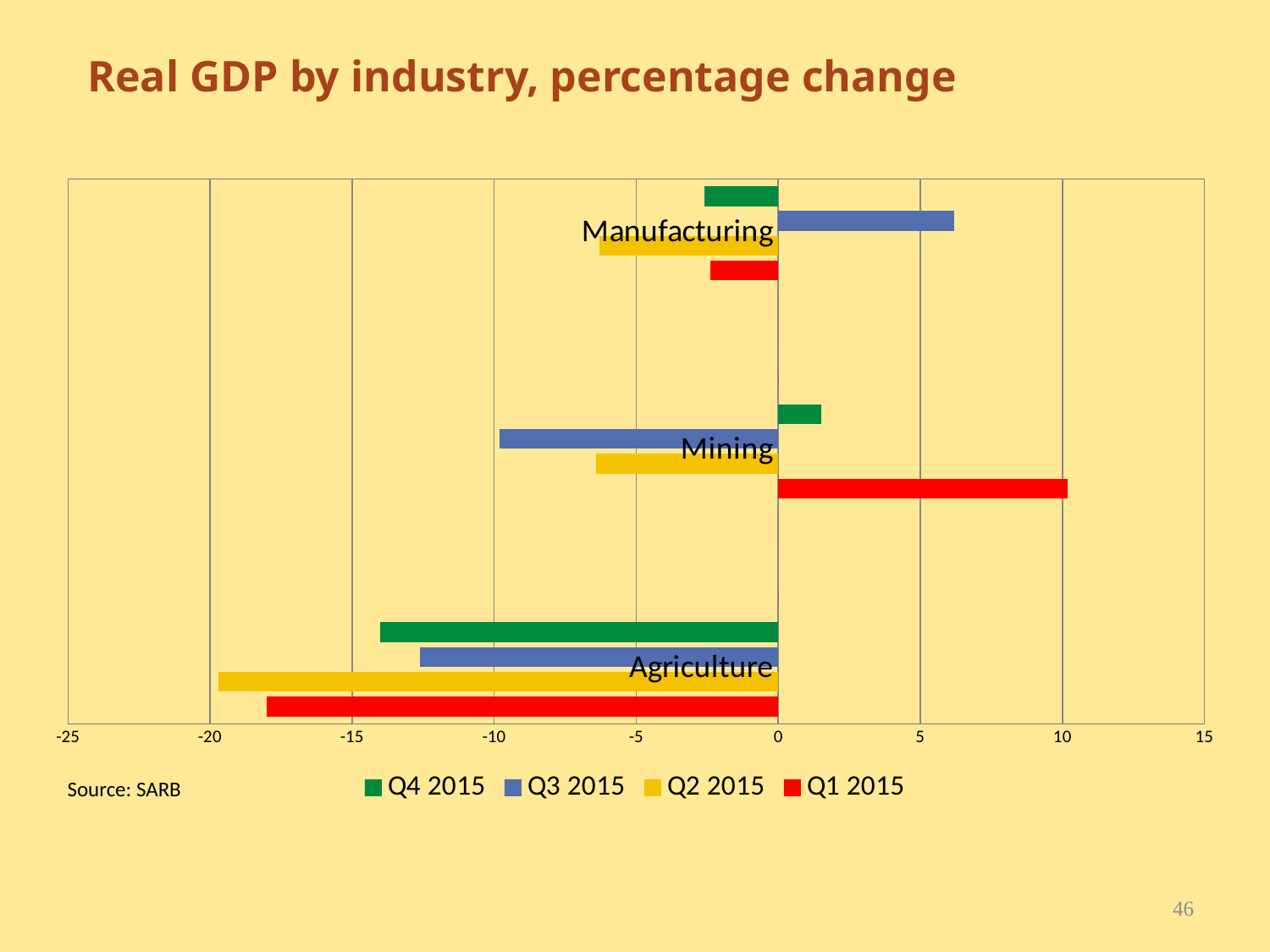
For Mining, which quarter has the highest value? Q1 2015 Is the value for Mining in Q1 2015 greater or less than 5? greater How many industries are shown on the chart? 3 Which industry and quarter has the lowest value on the chart? Agriculture, Q2 2015 What is the source cited for the chart? SARB Is the value for Agriculture in Q2 2015 greater or less than -15? less What kind of chart is shown on the slide? bar chart Which industry and quarter has the highest value on the chart? Mining, Q1 2015 How many series does the legend list? 4 Which is larger, the Q3 2015 value for Manufacturing or the Q3 2015 value for Mining? Manufacturing Is the value for Manufacturing in Q3 2015 greater or less than 5? greater For Agriculture, which quarter has the lowest value? Q2 2015